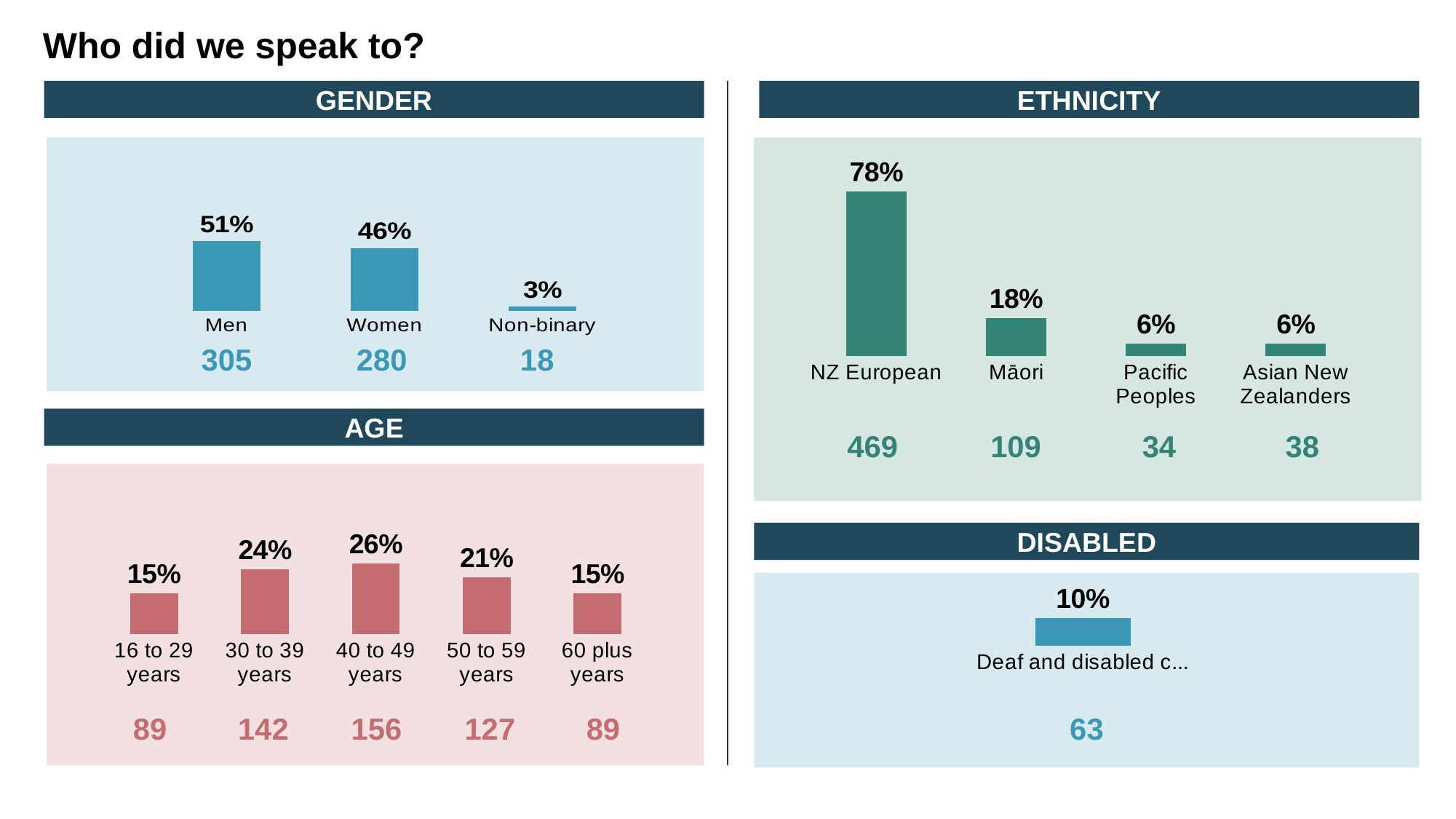
In the GENDER chart, what percentage is shown for Men? 51% How many age groups are shown in the AGE chart? 5 In the AGE chart, which age group has the highest percentage? 40 to 49 years In the ETHNICITY chart, what is the count shown for NZ European? 469 In the AGE chart, what is the count shown for 50 to 59 years? 127 In the GENDER chart, what is the count shown below Women? 280 In the ETHNICITY chart, which has the larger count, Pacific Peoples or Asian New Zealanders? Asian New Zealanders In the AGE chart, what is the difference in percentage points between 30 to 39 years and 16 to 29 years? 9 In the GENDER chart, which category has the lowest percentage? Non-binary What type of chart is used in the ETHNICITY section? Bar chart In the ETHNICITY chart, what percentage is shown for Māori? 18% In the DISABLED chart, what percentage is shown for the single bar? 10%